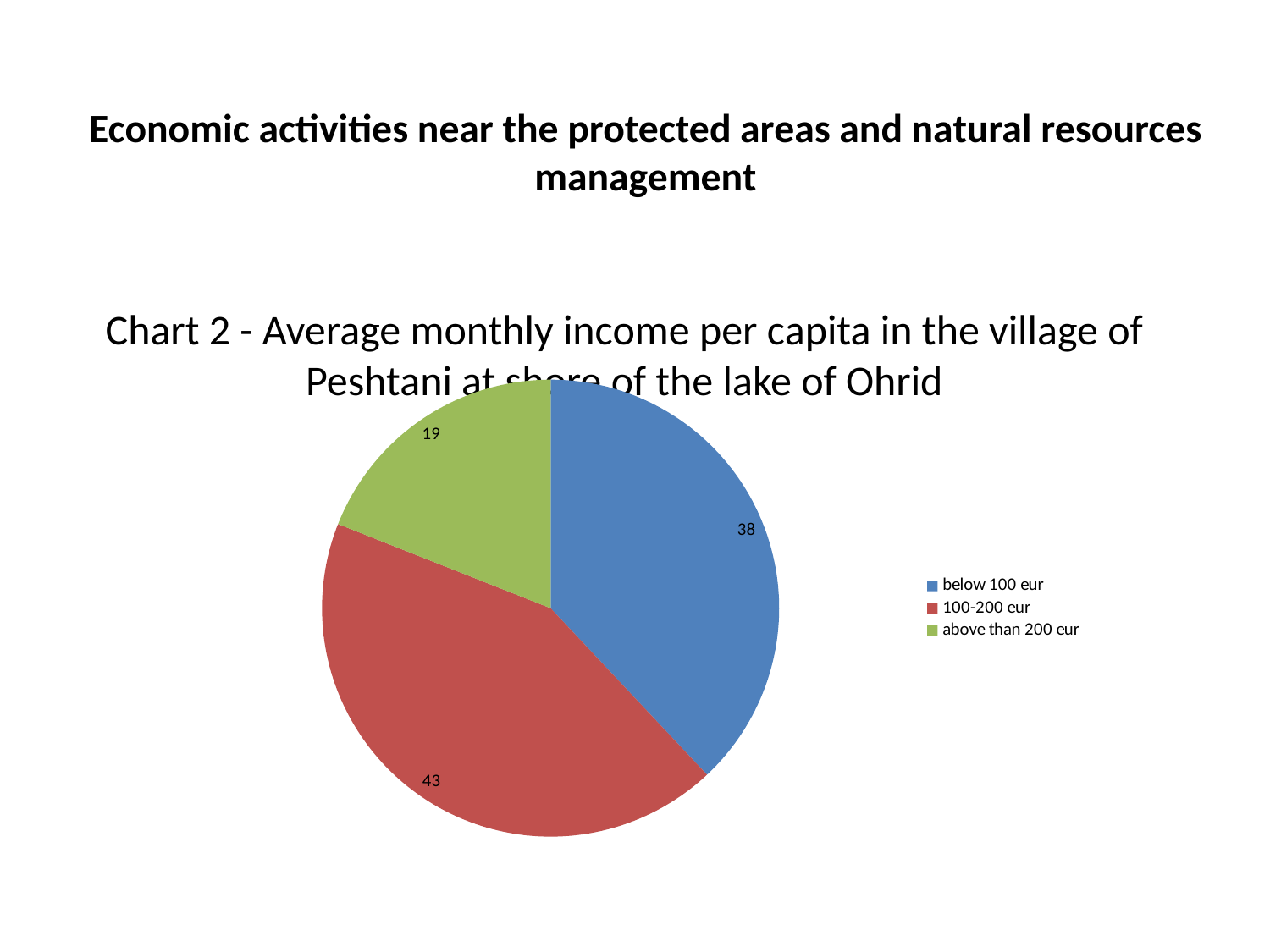
Which is larger, the "below 100 eur" slice or the "above than 200 eur" slice? below 100 eur What is the difference between the "100-200 eur" value and the "below 100 eur" value? 5 What is the value for the "below 100 eur" slice? 38 What colour is the "100-200 eur" slice? red What share of the pie does the "above than 200 eur" slice represent? 19% What kind of chart is shown on the slide? pie chart Which income category has the largest slice? 100-200 eur What is the difference between the "below 100 eur" value and the "above than 200 eur" value? 19 What is the value for the "above than 200 eur" slice? 19 What is the value for the "100-200 eur" slice? 43 How many slices does the pie chart have? 3 Which income category has the smallest slice? above than 200 eur